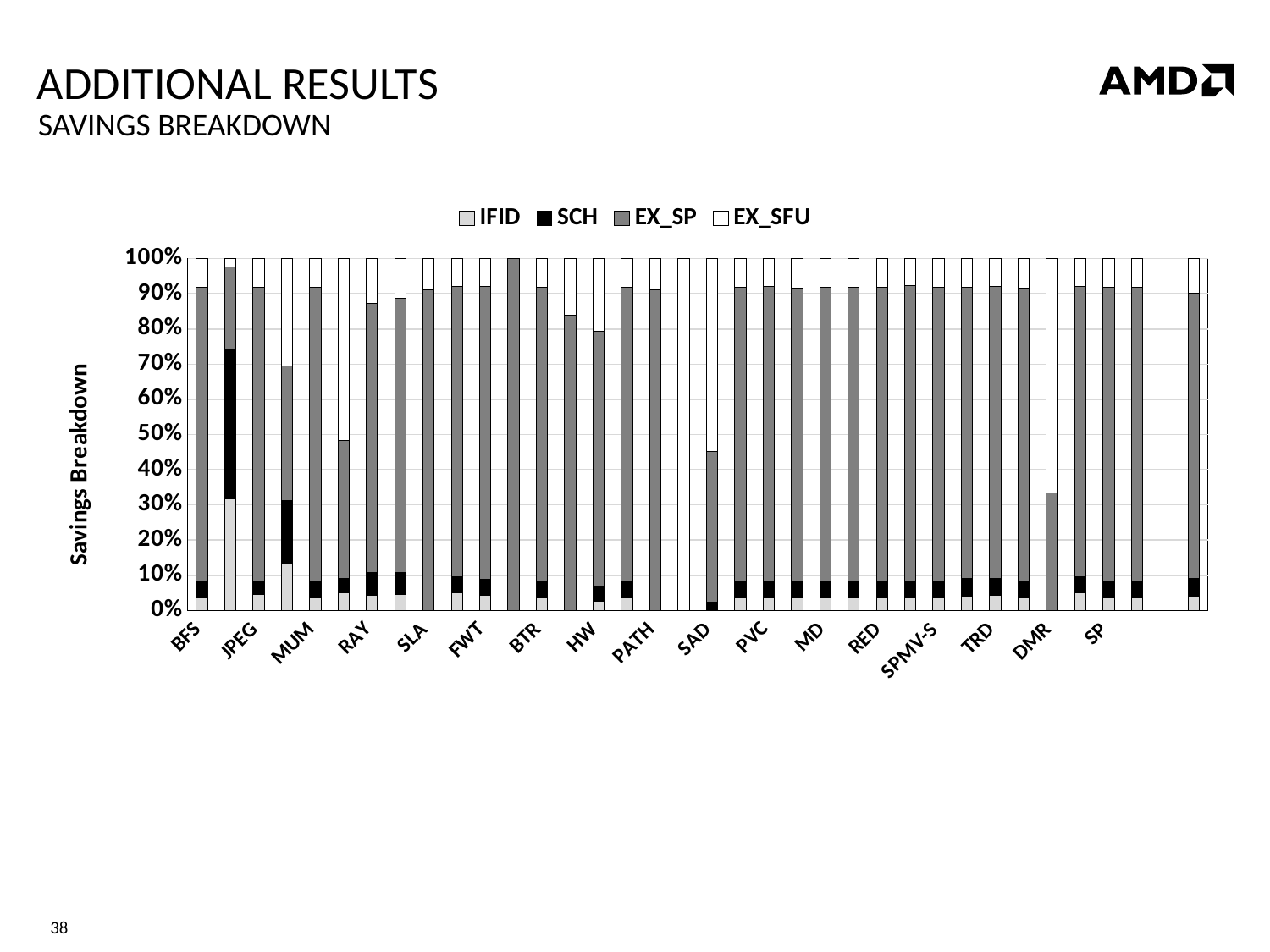
Is the IFID share for BFS greater or less than 10%? less What is the maximum value shown on the vertical axis? 100% How many series does the legend list? 4 Is the EX_SFU share for HW greater or less than 10%? greater Is the EX_SFU share for PATH greater or less than 20%? less Which has the larger EX_SFU share, BFS or SAD? SAD What kind of chart is shown on the slide? stacked bar chart What is the title of the vertical axis? Savings Breakdown What are the series names listed in the legend? IFID, SCH, EX_SP, EX_SFU